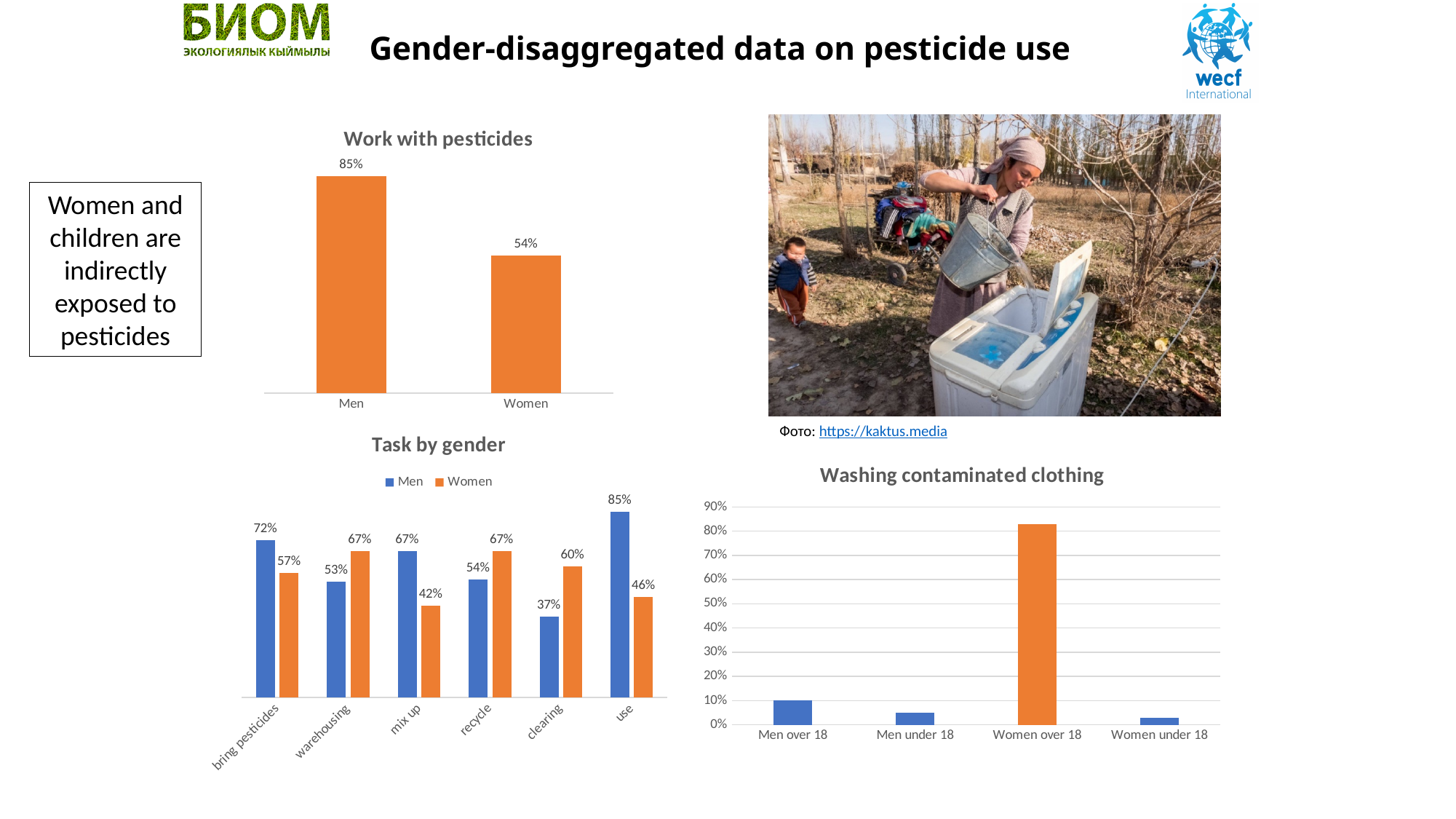
In the 'Task by gender' chart, which is larger for 'warehousing': the value for Men or for Women? Women In the 'Task by gender' chart, how many task categories are shown on the x axis? 6 In the 'Task by gender' chart, what is the value for Men for 'mix up'? 67% In the 'Task by gender' chart, how many series does the legend list? 2 In the 'Task by gender' chart, which task has the lowest value for Women? mix up What kind of chart is 'Washing contaminated clothing'? Bar chart In the 'Task by gender' chart, which task has the highest value for Men? use In the 'Washing contaminated clothing' chart, which category has the highest value? Women over 18 In the 'Work with pesticides' chart, what is the value for Men? 85% In the 'Washing contaminated clothing' chart, is the value for Women over 18 greater or less than 70%? greater In the 'Work with pesticides' chart, what is the difference between the values for Men and Women? 31% In the 'Task by gender' chart, what is the value for Women for 'clearing'? 60%